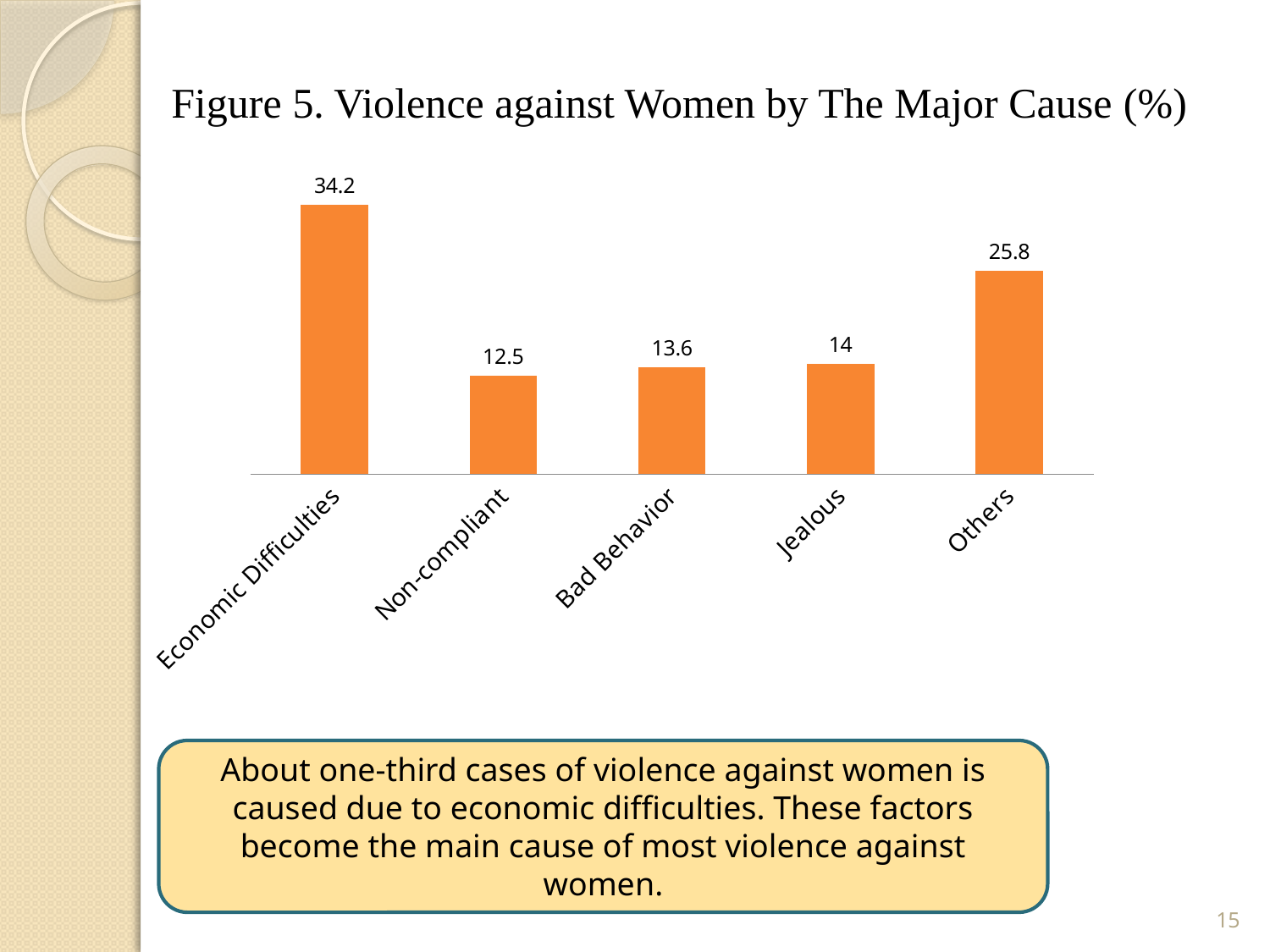
What kind of chart is shown on the slide? Bar chart What is the value for Bad Behavior? 13.6 What is the value for Jealous? 14 What is the difference between the values for Economic Difficulties and Others? 8.4 Which cause has the highest value? Economic Difficulties What is the value for Others? 25.8 How many causes are shown in the chart? 5 Which cause has the lowest value? Non-compliant What is the value for Non-compliant? 12.5 What is the value for Economic Difficulties? 34.2 What is the difference between the values for Jealous and Non-compliant? 1.5 Which is larger, the value for Others or the value for Bad Behavior? Others